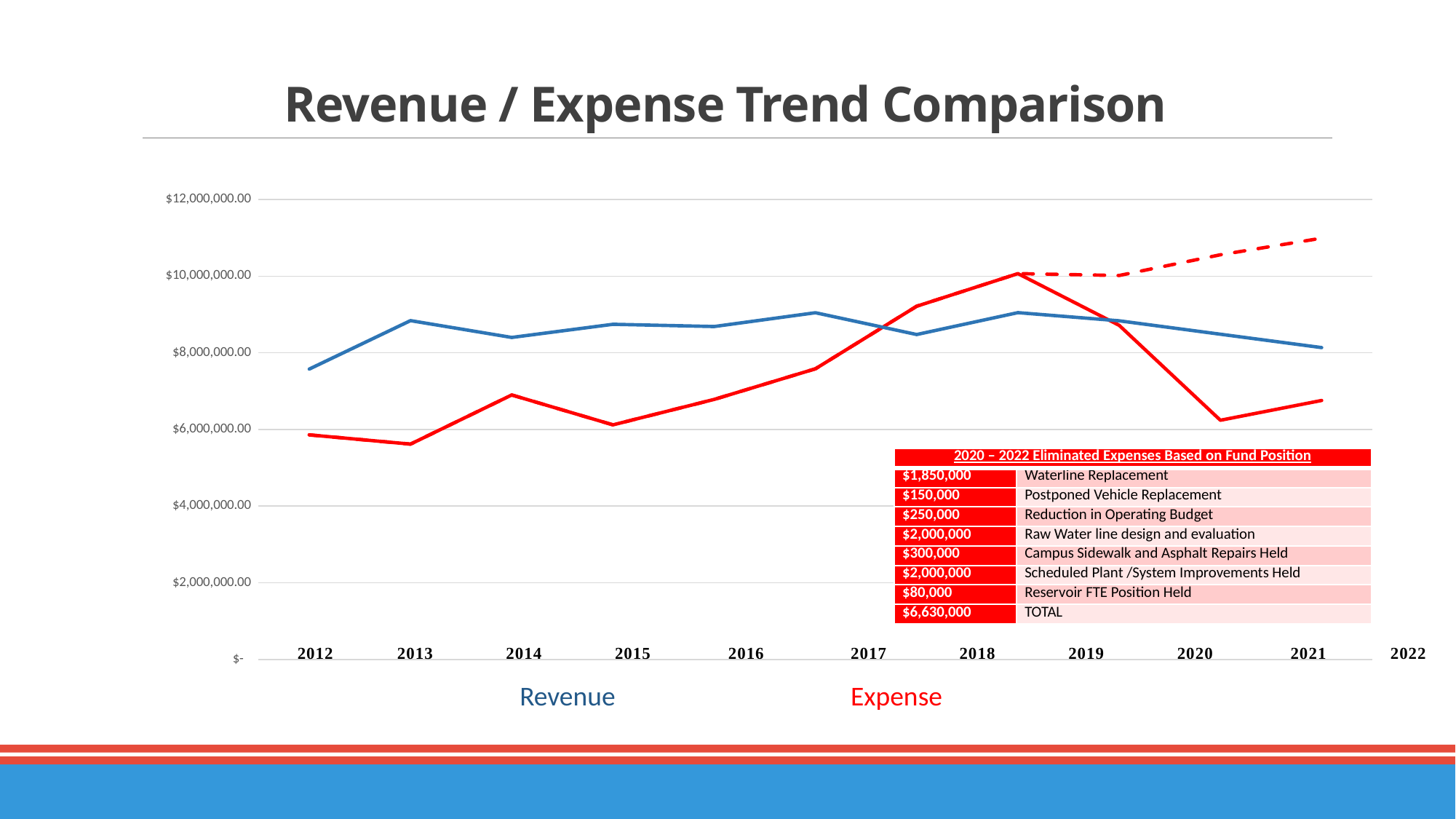
Which is larger in 2020, Revenue or Expense? Revenue Which is larger in 2018, Revenue or Expense? Expense What kind of chart is shown on the slide? line chart How many series does the chart legend list? 2 What is the title of the chart slide? Revenue / Expense Trend Comparison Is the Expense value for 2017 greater or less than $8,000,000.00? greater What colour is the Expense line? red In which year is the Expense value highest? 2018 Is the Revenue value for 2012 greater or less than $8,000,000.00? less Is the Expense value for 2014 greater or less than $6,000,000.00? greater In which year is the Revenue value lowest? 2012 Does the Expense line rise or fall from 2018 to 2020? fall